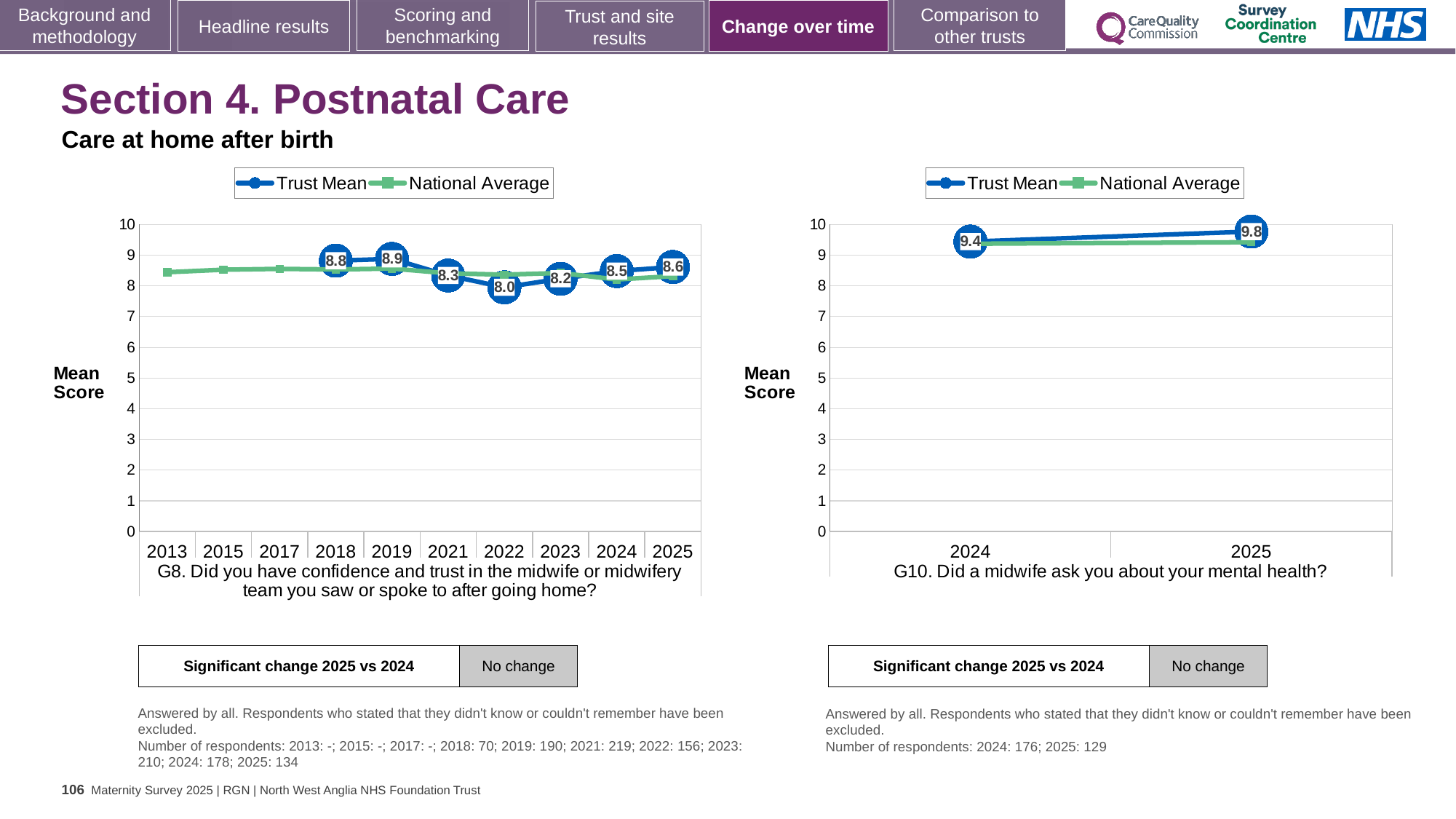
In the G8 chart, which year has the lowest labelled Trust Mean? 2022 In the G10 chart, what is the Trust Mean for 2025? 9.8 In the G8 chart, what is the difference between the Trust Mean for 2025 and the Trust Mean for 2024? 0.1 In the G10 chart, what is the difference between the Trust Mean for 2025 and the Trust Mean for 2024? 0.4 In the G8 chart, what is the Trust Mean for 2019? 8.9 In the G8 chart, which year has the highest labelled Trust Mean? 2019 How many series does the legend of the G8 chart list? 2 In the G10 chart, is the National Average for 2024 greater or less than 8? greater In the G8 chart, is the Trust Mean higher in 2018 or in 2021? 2018 In the G8 chart, what is the Trust Mean for 2022? 8.0 In the G8 chart, how many years are shown on the x axis? 10 In the G10 chart, does the Trust Mean rise or fall from 2024 to 2025? rise